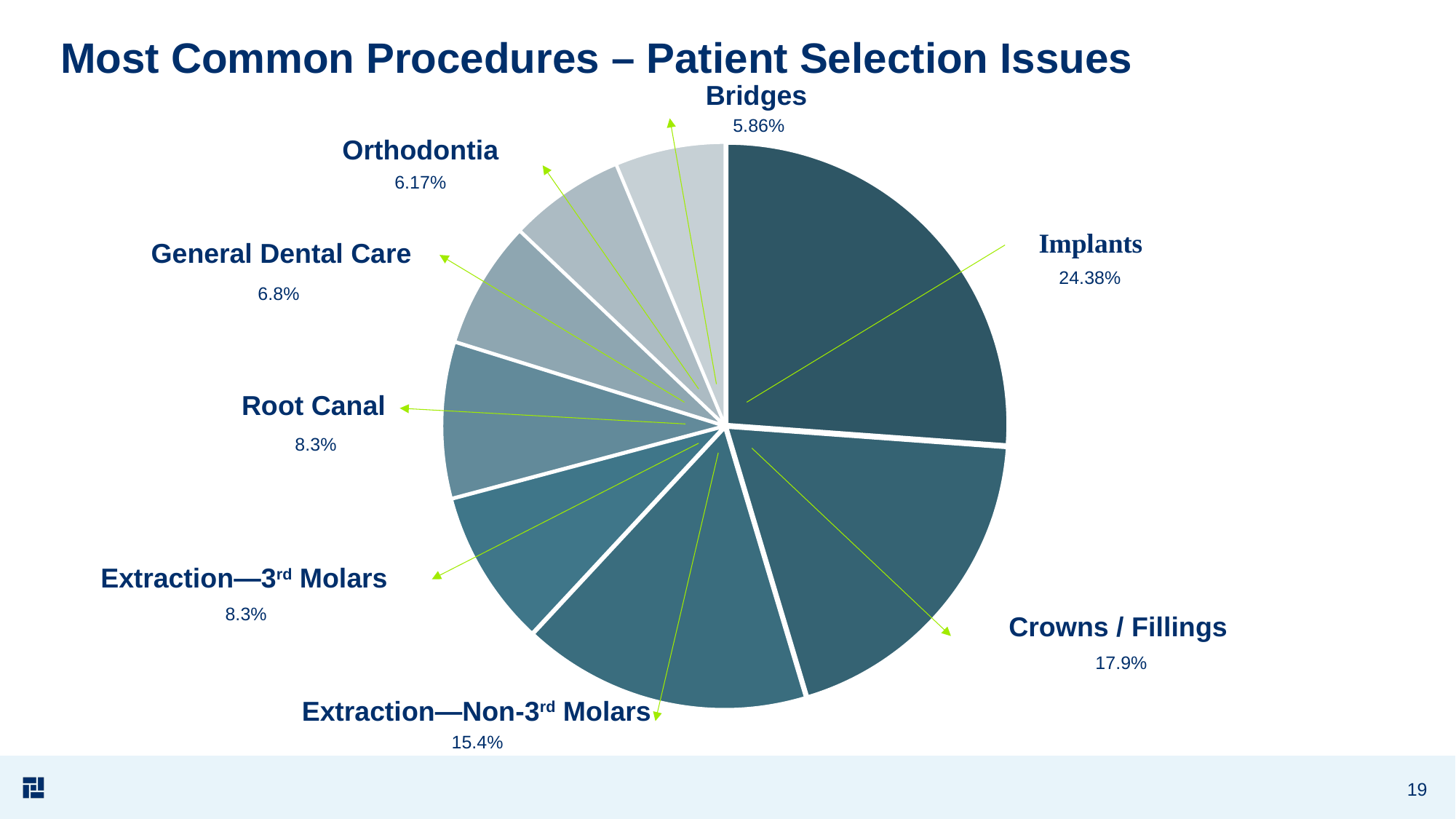
What share of the pie does Implants represent? 24.38% Which procedure has the largest slice of the pie? Implants What is the value for General Dental Care? 6.8% What is the difference between the Implants share and the Crowns / Fillings share? 6.48% What percentage is shown for Extraction—Non-3rd Molars? 15.4% What is the value shown for Crowns / Fillings? 17.9% Which is larger, Crowns / Fillings or Extraction—Non-3rd Molars? Crowns / Fillings What percentage is shown for Orthodontia? 6.17% Which procedure has the smallest slice of the pie? Bridges What kind of chart is shown on the slide? Pie chart What is the title of the slide? Most Common Procedures – Patient Selection Issues How many procedure categories are shown in the pie chart? 8